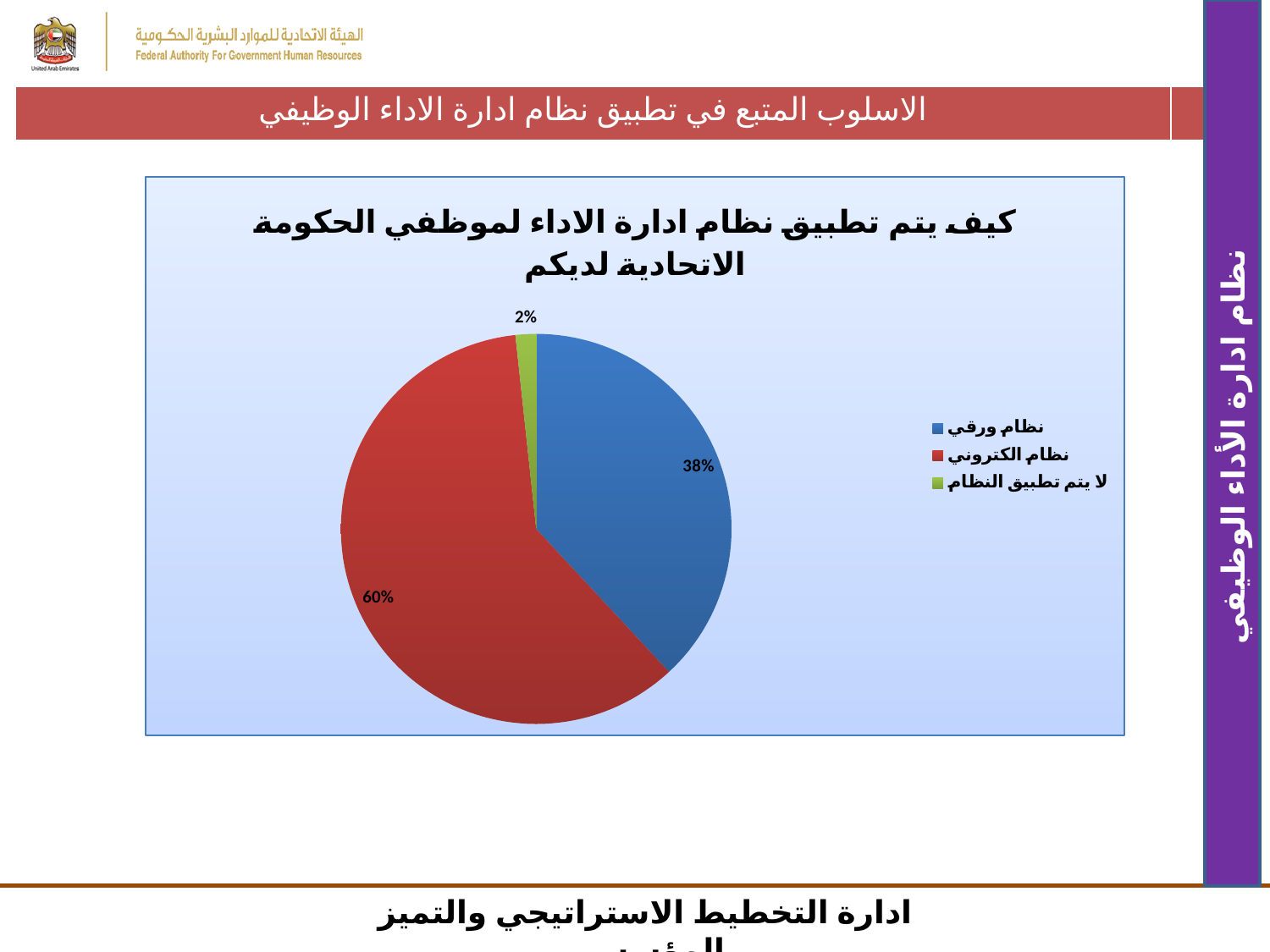
What percentage of the pie is labelled for لا يتم تطبيق النظام? 2% Which is larger, the share for نظام ورقي or the share for لا يتم تطبيق النظام? نظام ورقي What percentage of the pie is labelled for نظام الكتروني? 60% Which category has the smallest share of the pie? لا يتم تطبيق النظام What percentage of the pie is labelled for نظام ورقي? 38% What kind of chart is shown on the slide? pie chart Which category has the largest share of the pie? نظام الكتروني What is the difference in percentage points between نظام الكتروني and نظام ورقي? 22 How many slices does the pie chart have? 3 What colour is the slice for نظام الكتروني? red How many entries does the legend list? 3 What is the title of the pie chart? كيف يتم تطبيق نظام ادارة الاداء لموظفي الحكومة الاتحادية لديكم